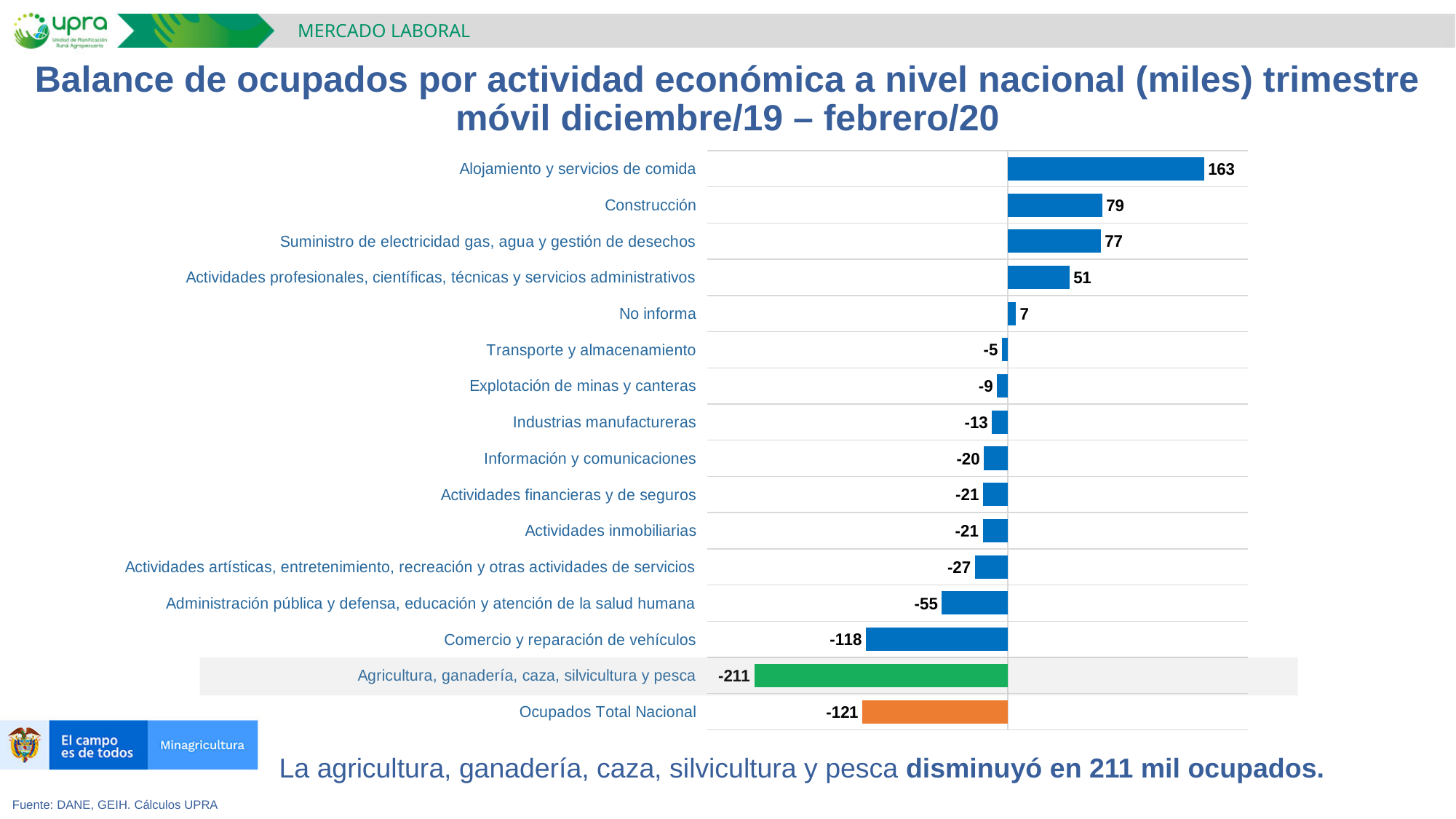
Which category has the lowest value? Agricultura, ganadería, caza, silvicultura y pesca What kind of chart is shown on the slide? Bar chart What is the value for Agricultura, ganadería, caza, silvicultura y pesca? -211 What is the value for Administración pública y defensa, educación y atención de la salud humana? -55 Which category has the highest value? Alojamiento y servicios de comida What is the value for Comercio y reparación de vehículos? -118 What is the difference between the values for Construcción and Suministro de electricidad gas, agua y gestión de desechos? 2 Which is larger, the value for Actividades profesionales, científicas, técnicas y servicios administrativos or the value for No informa? Actividades profesionales, científicas, técnicas y servicios administrativos What is the value for Ocupados Total Nacional? -121 What is the value for Alojamiento y servicios de comida? 163 What colour is the bar for Agricultura, ganadería, caza, silvicultura y pesca? Green How many categories are shown in the chart? 16